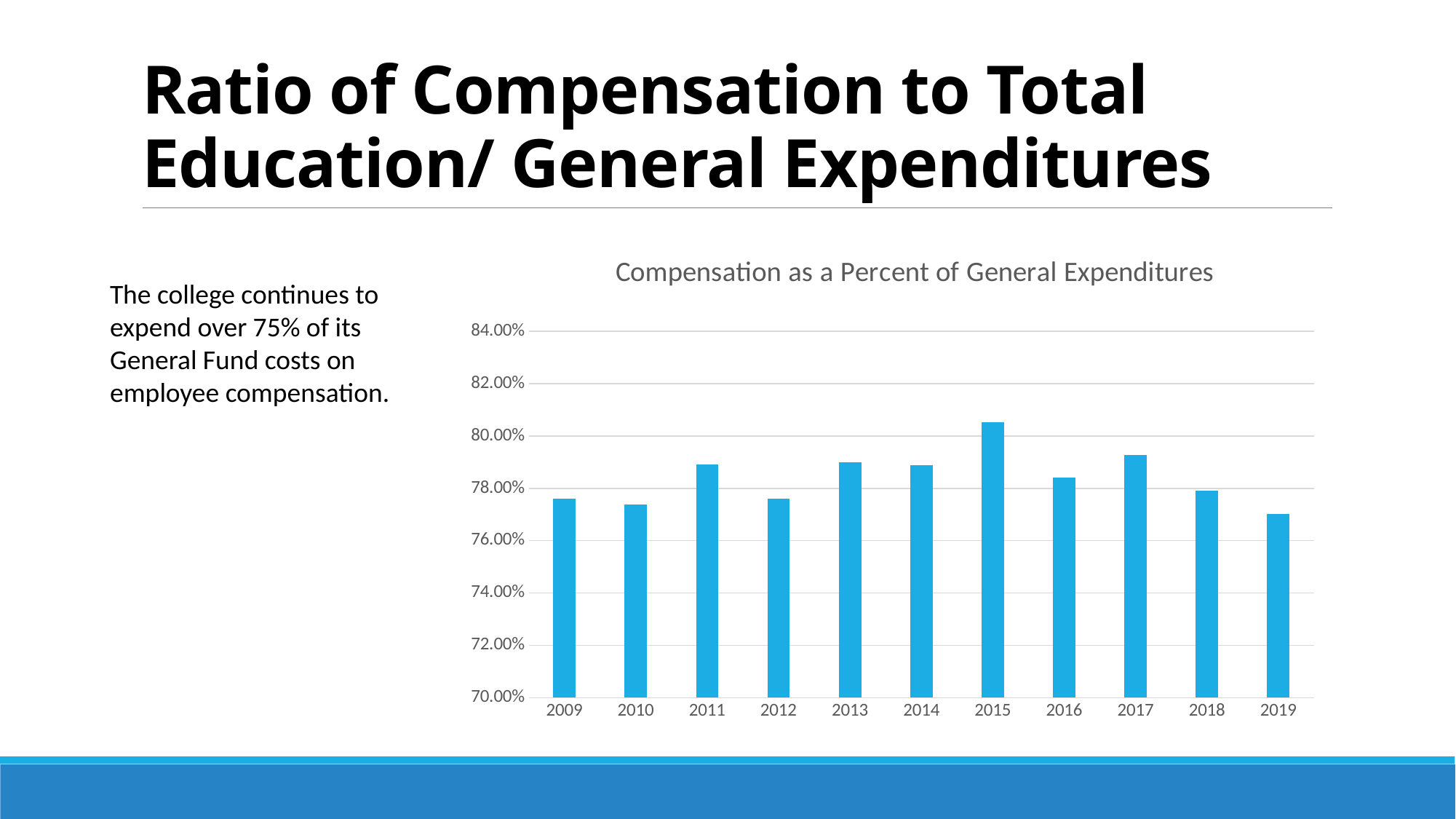
Which year has the larger value, 2011 or 2010? 2011 Which year has the larger value, 2017 or 2016? 2017 Is the value for 2017 greater or less than 78.00%? greater Which year has the highest compensation as a percent of general expenditures? 2015 What kind of chart is shown on the slide? bar chart Do the values rise or fall from 2017 to 2019? fall Which year has the lowest compensation as a percent of general expenditures? 2019 How many years are shown on the x axis of the chart? 11 Is the value for 2019 greater or less than 78.00%? less Is the value for 2010 greater or less than 78.00%? less What is the title of the chart? Compensation as a Percent of General Expenditures